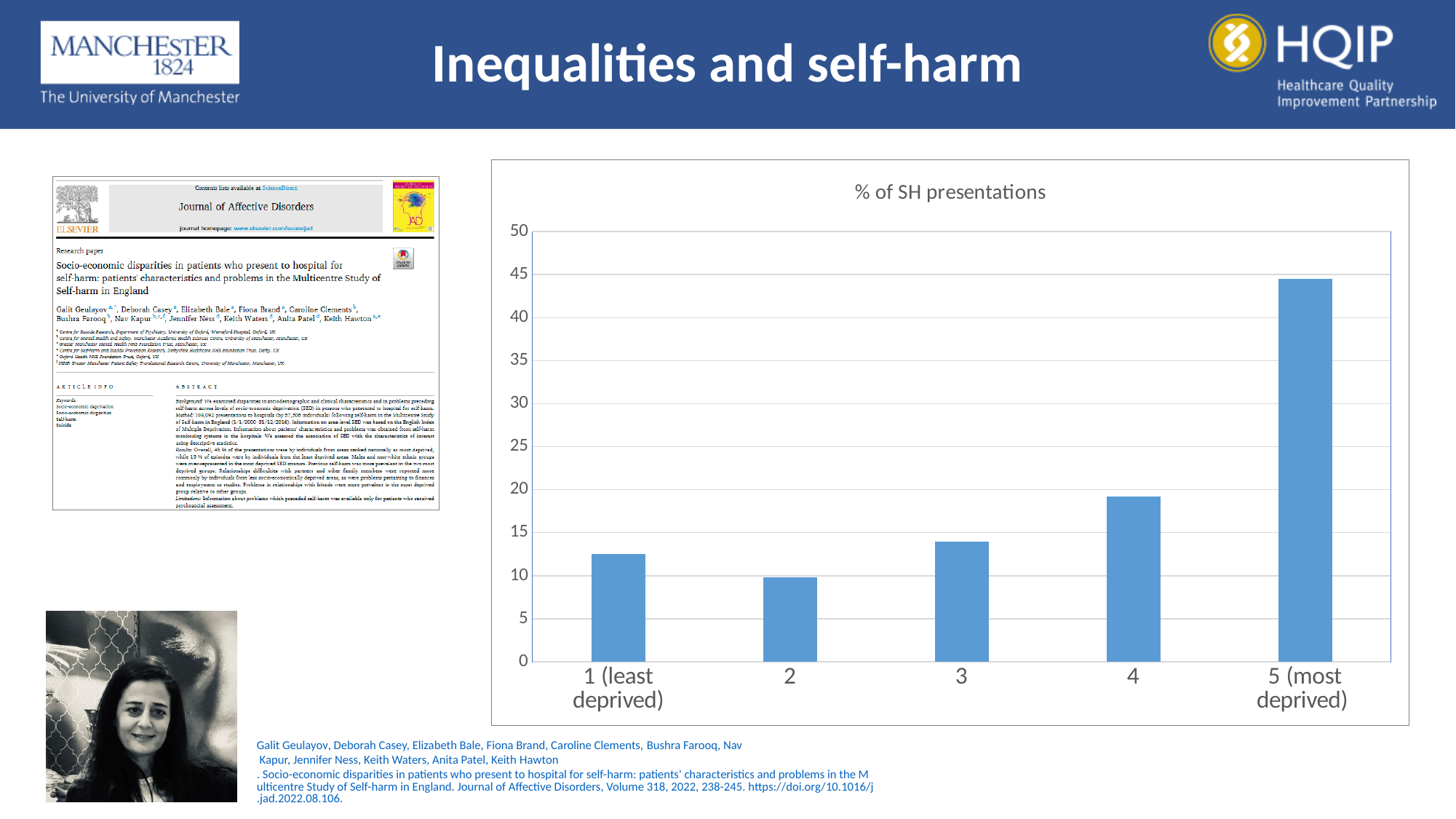
Is the value for 4 greater or less than 15? greater What kind of chart is shown on the slide? bar chart How many deprivation categories are plotted on the chart? 5 What is the maximum value shown on the vertical axis? 50 Is the value for 5 (most deprived) greater or less than 40? greater Which category has the lowest % of SH presentations? 2 What is the title of the chart? % of SH presentations Is the value for 1 (least deprived) greater or less than 15? less Which is larger, the value for category 3 or the value for category 2? 3 Which category has the highest % of SH presentations? 5 (most deprived) Which is larger, the value for category 4 or the value for 1 (least deprived)? 4